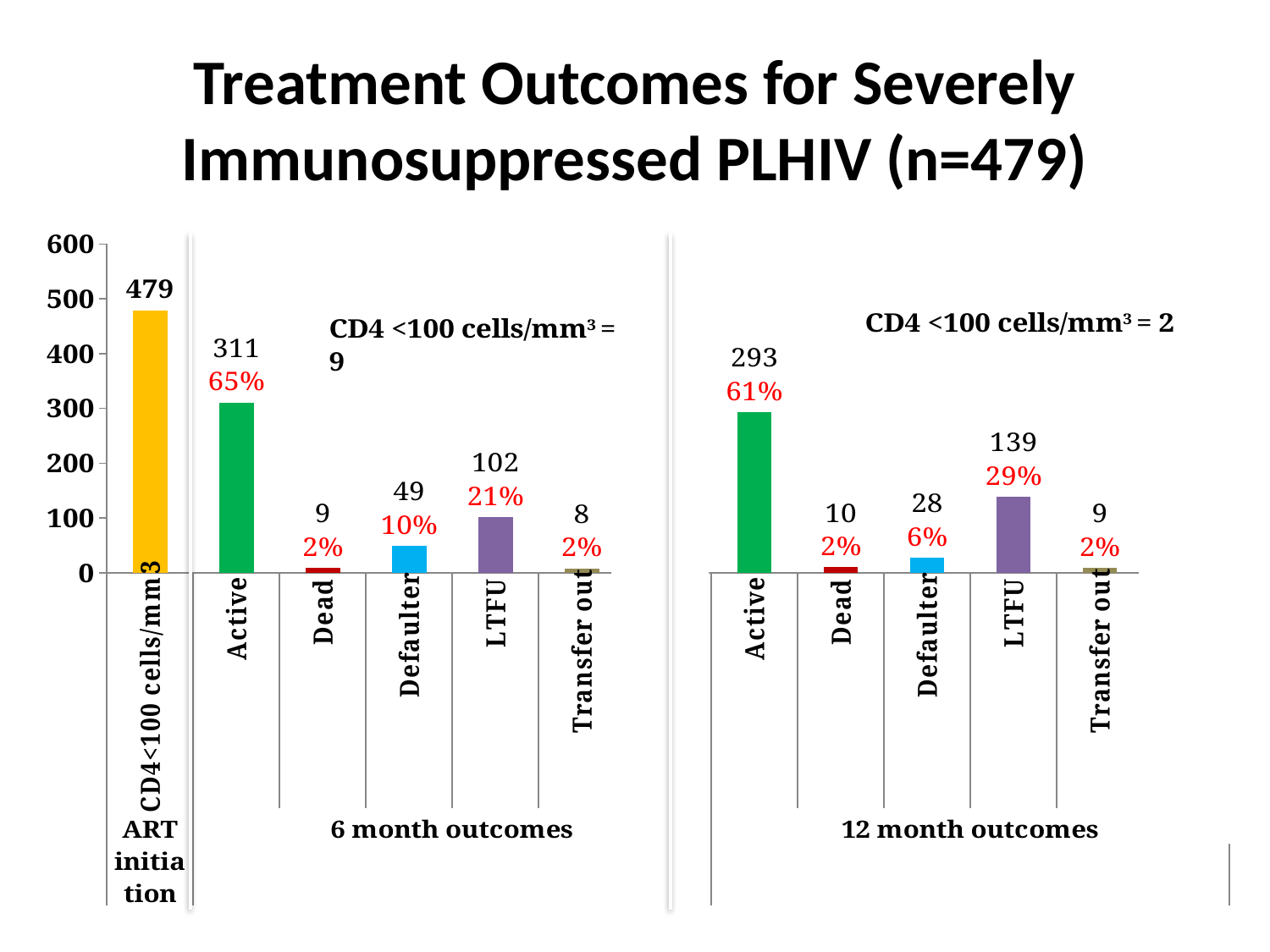
What is the difference between the LTFU values at 12 months and at 6 months? 37 What is the value for LTFU in the 12 month outcomes group? 139 Which category has the highest value in the 12 month outcomes group? Active Is the value for Active in the 6 month outcomes group greater or less than 300? greater What percentage is shown for Defaulter in the 6 month outcomes group? 10% How many outcome categories are shown in the 12 month outcomes group? 5 Which category has the lowest value in the 6 month outcomes group? Transfer out What is the value of the ART initiation bar (CD4<100 cells/mm3)? 479 What is the value for Active in the 6 month outcomes group? 311 What percentage is shown for Active in the 12 month outcomes group? 61% What kind of chart is shown on the slide? bar chart Which is larger, the Defaulter value at 6 months or the Defaulter value at 12 months? 6 months